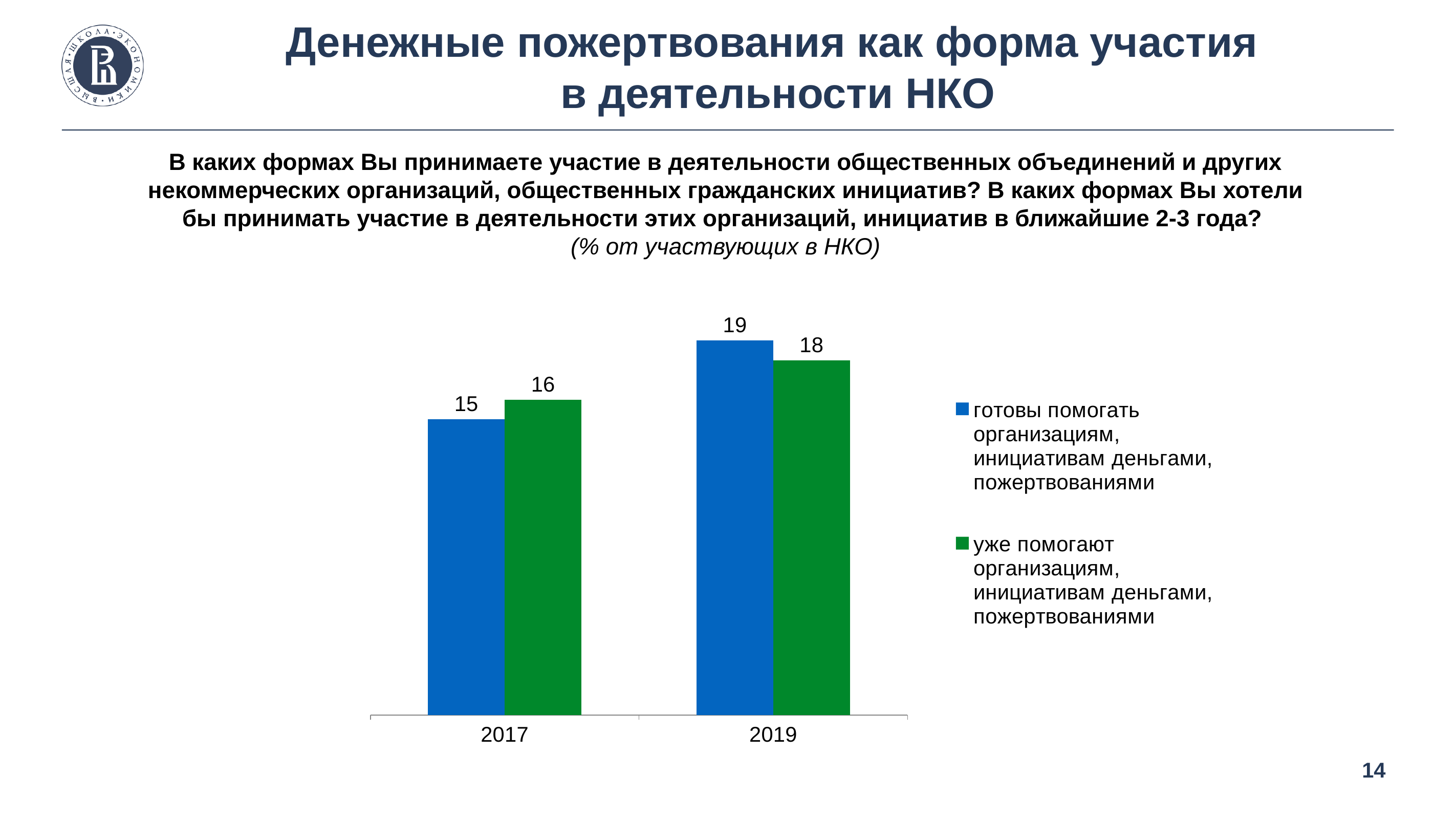
How many series does the legend list? 2 What is the value for 'уже помогают организациям, инициативам деньгами, пожертвованиями' in 2017? 16 What is the difference between the 2019 and 2017 values for 'готовы помогать организациям, инициативам деньгами, пожертвованиями'? 4 What is the value for 'готовы помогать организациям, инициативам деньгами, пожертвованиями' in 2019? 19 In 2017, which series has the larger value: 'готовы помогать' or 'уже помогают'? уже помогают How many years are shown on the x axis? 2 What is the value for 'уже помогают организациям, инициативам деньгами, пожертвованиями' in 2019? 18 Does the value for 'уже помогают организациям, инициативам деньгами, пожертвованиями' rise or fall from 2017 to 2019? rise Which year has the highest value for 'готовы помогать организациям, инициативам деньгами, пожертвованиями'? 2019 What is the value for 'готовы помогать организациям, инициативам деньгами, пожертвованиями' in 2017? 15 Which year has the lowest value for 'уже помогают организациям, инициативам деньгами, пожертвованиями'? 2017 What kind of chart is shown on the slide? bar chart